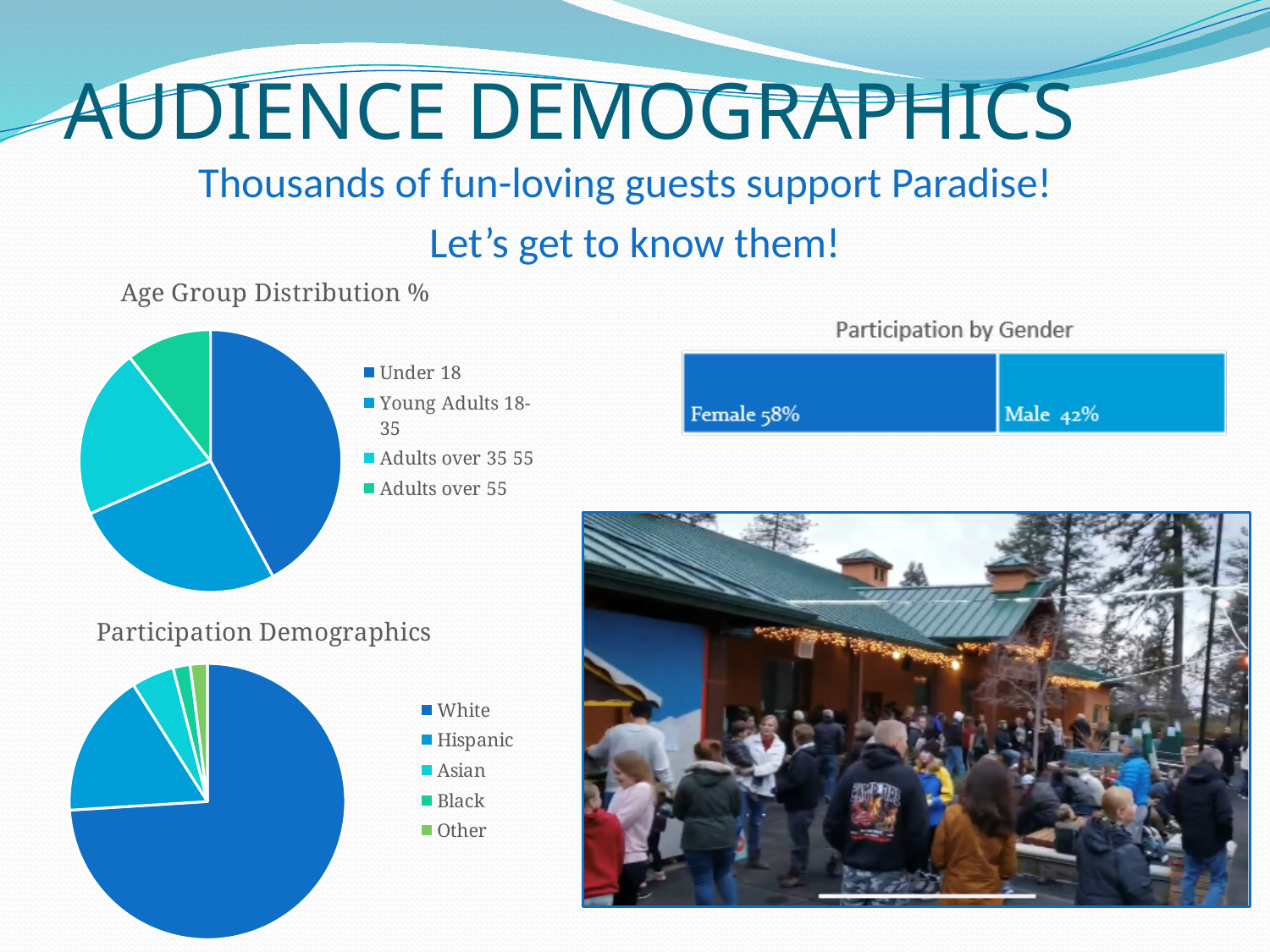
In the Participation by Gender chart, what is the difference between the Female and Male percentages? 16 percentage points What kind of chart is the Age Group Distribution % chart? Pie chart In the Participation by Gender chart, which is larger, Female or Male? Female How many categories does the legend of the Participation Demographics chart list? 5 In the Participation Demographics chart, which category has the largest slice? White In the Participation Demographics chart, which slice is larger, Hispanic or Asian? Hispanic In the Age Group Distribution % chart, which age group has the smallest slice? Adults over 55 What kind of chart is the Participation by Gender chart? Bar chart In the Age Group Distribution % chart, which age group has the largest slice? Under 18 In the Participation by Gender chart, what is the value for Male? 42% How many age groups are shown in the Age Group Distribution % chart? 4 In the Participation by Gender chart, what is the value for Female? 58%